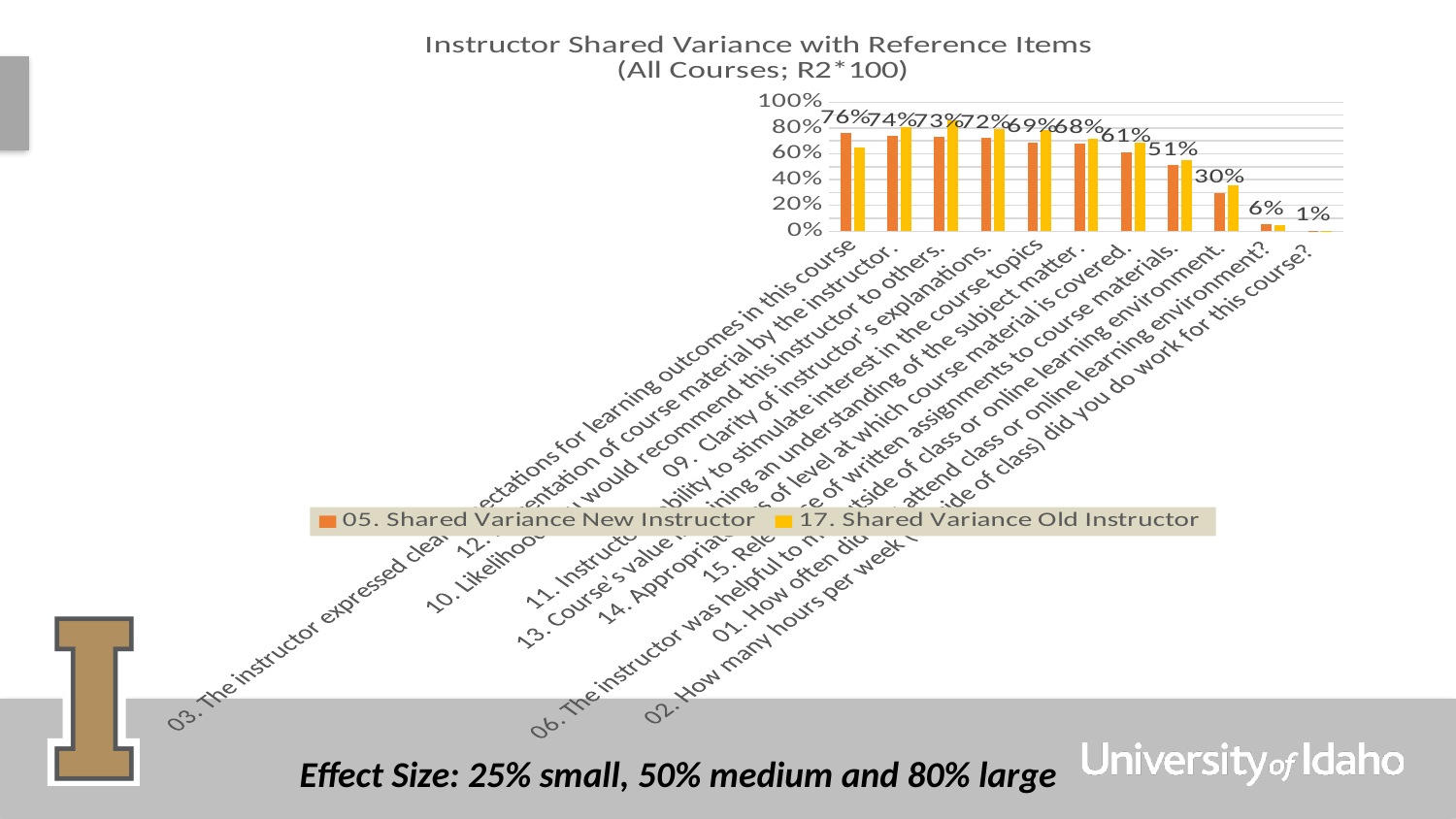
What is the highest labelled value for the 05. Shared Variance New Instructor series? 76% What kind of chart is shown on the slide? Bar chart What are the two series named in the legend? 05. Shared Variance New Instructor; 17. Shared Variance Old Instructor What is the 05. Shared Variance New Instructor value for '01. How often did you attend class or online learning environment?' 6% Do the 05. Shared Variance New Instructor values rise or fall moving from left to right along the x axis? Fall What is the lowest labelled value for the 05. Shared Variance New Instructor series? 1% How many series does the legend list? 2 What is the title of the chart? Instructor Shared Variance with Reference Items (All Courses; R2*100) What is the 05. Shared Variance New Instructor value for '09. Clarity of instructor's explanations.'? 72% How many categories (survey items) are plotted on the x axis? 11 What is the difference between the highest (76%) and lowest (1%) labelled values for the 05. Shared Variance New Instructor series? 75 percentage points What is the 05. Shared Variance New Instructor value for '02. How many hours per week (outside of class) did you do work for this course?' 1%